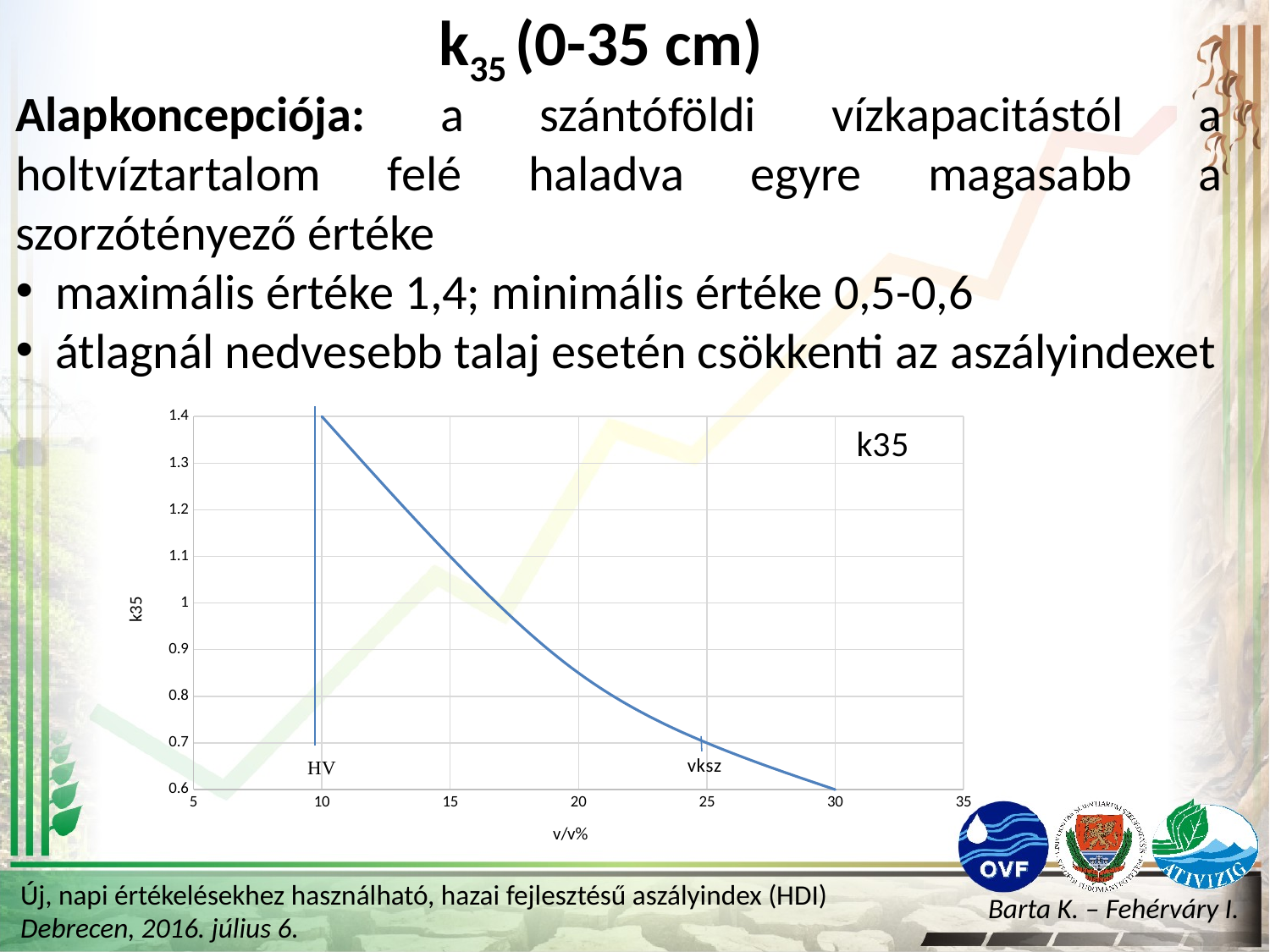
What is the difference between the k35 value at v/v% = 10 and at v/v% = 30? 0.8 Which has the larger k35 value: v/v% = 10 or v/v% = 30? v/v% = 10 What is the k35 value at the start of the curve, at v/v% = 10? 1.4 Is the k35 value at v/v% = 20 greater or less than 0.8? greater Does the k35 value rise or fall as v/v% increases along the x axis? fall What kind of chart is shown on the slide? line chart What is the title of the x axis of the chart? v/v% What is the k35 value at the end of the curve, at v/v% = 30? 0.6 Is the k35 value at v/v% = 15 greater or less than 1.0? greater Is the k35 value at v/v% = 20 greater or less than 1.0? less